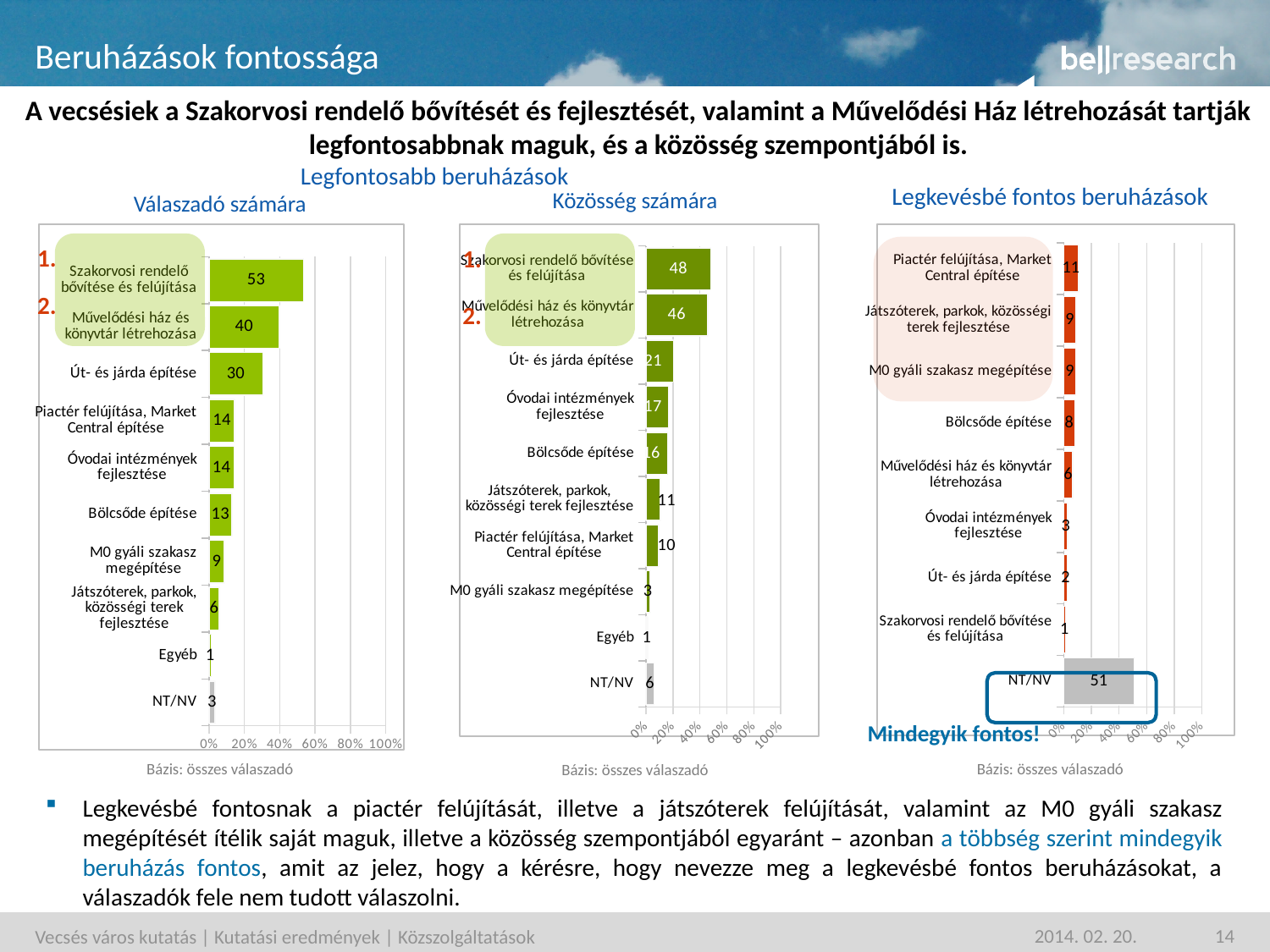
In the 'Legkevésbé fontos beruházások' chart on the right, what is the value for 'NT/NV'? 51 In the 'Válaszadó számára' chart on the left, what is the difference between 'Szakorvosi rendelő bővítése és felújítása' and 'Művelődési ház és könyvtár létrehozása'? 13 In the 'Közösség számára' chart in the middle, which is larger: 'Játszóterek, parkok, közösségi terek fejlesztése' or 'Piactér felújítása, Market Central építése'? Játszóterek, parkok, közösségi terek fejlesztése In the 'Közösség számára' chart in the middle, what is the value for 'Óvodai intézmények fejlesztése'? 17 How many categories are shown in the 'Válaszadó számára' chart on the left? 10 In the 'Közösség számára' chart in the middle, which category has the highest value? Szakorvosi rendelő bővítése és felújítása In the 'Legkevésbé fontos beruházások' chart on the right, which category has the lowest value? Szakorvosi rendelő bővítése és felújítása What type of chart is the 'Közösség számára' chart in the middle? Bar chart In the 'Válaszadó számára' chart on the left, what is the value for 'Út- és járda építése'? 30 In the 'Válaszadó számára' chart on the left, what is the value for 'Szakorvosi rendelő bővítése és felújítása'? 53 In the 'Legkevésbé fontos beruházások' chart on the right, what is the value for 'Piactér felújítása, Market Central építése'? 11 In the 'Válaszadó számára' chart on the left, is the value for 'Szakorvosi rendelő bővítése és felújítása' greater or less than 40%? greater